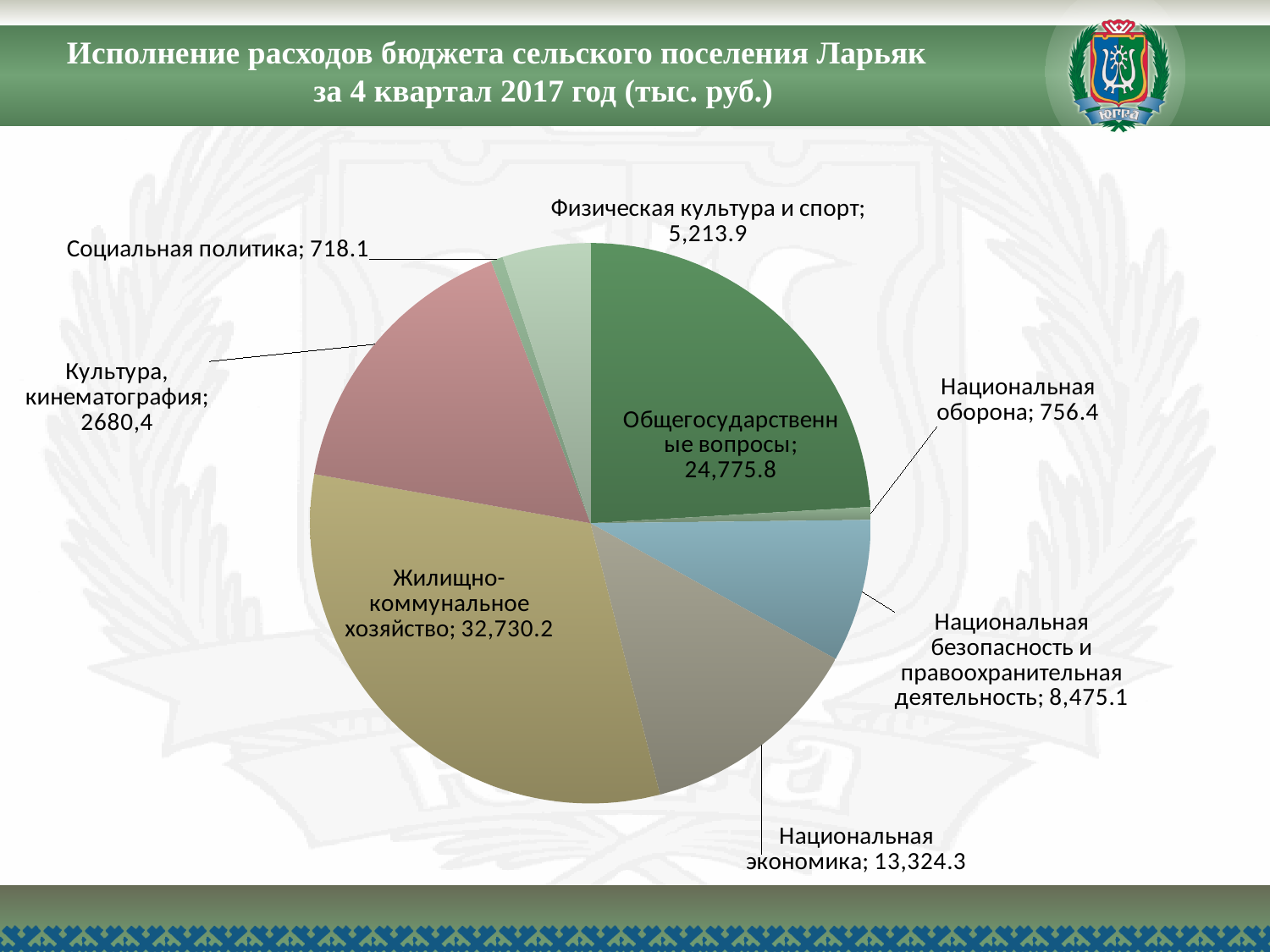
What is the value for Общегосударственные вопросы? 24,775.8 Which category has the smallest value in the pie chart? Социальная политика Which category has the largest slice of the pie? Жилищно-коммунальное хозяйство What is the value for Физическая культура и спорт? 5,213.9 How many categories (slices) does the pie chart have? 8 What is the difference between the values for Жилищно-коммунальное хозяйство and Общегосударственные вопросы? 7,954.4 What is the value for Национальная безопасность и правоохранительная деятельность? 8,475.1 What is the value for Жилищно-коммунальное хозяйство? 32,730.2 What is the value for Национальная экономика? 13,324.3 In what units are the values in the chart expressed, according to the slide title? тыс. руб. What kind of chart is shown on the slide? Pie chart Which is larger: Национальная экономика or Национальная безопасность и правоохранительная деятельность? Национальная экономика